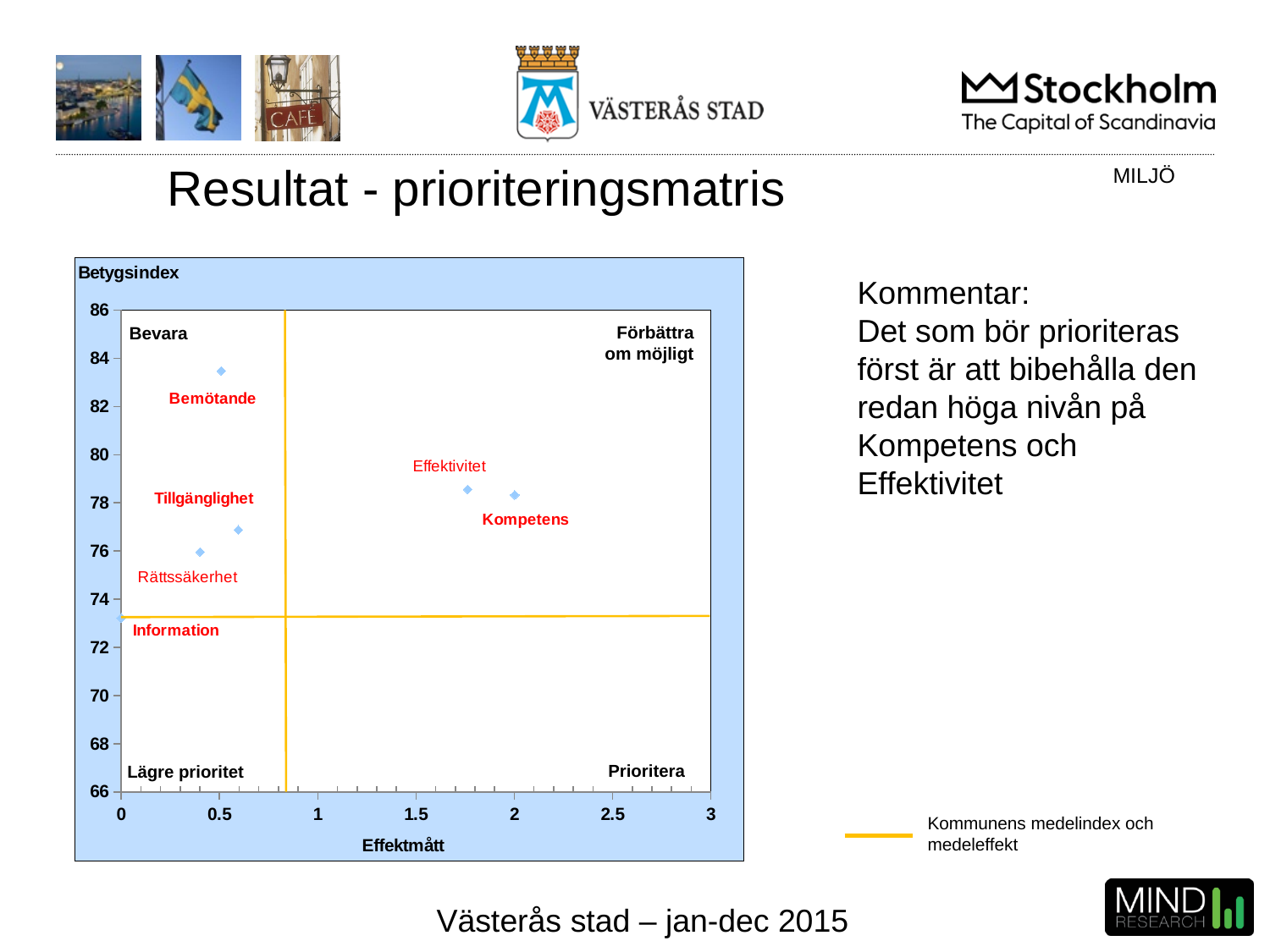
Is the Betygsindex for Information greater or less than 74? less Which quadrant label appears in the top-right corner of the chart? Förbättra om möjligt What is the label of the x axis of the chart? Effektmått Which category has the highest Betygsindex? Bemötande Is the Effektmått for Kompetens greater or less than 1.5? greater Which category has the lowest Betygsindex? Information Is the Betygsindex for Rättssäkerhet greater or less than 78? less Which category has the highest Effektmått value? Kompetens Which has a higher Betygsindex, Bemötande or Tillgänglighet? Bemötande What kind of chart is shown on the slide? Scatter plot How many data points are plotted in the chart? 6